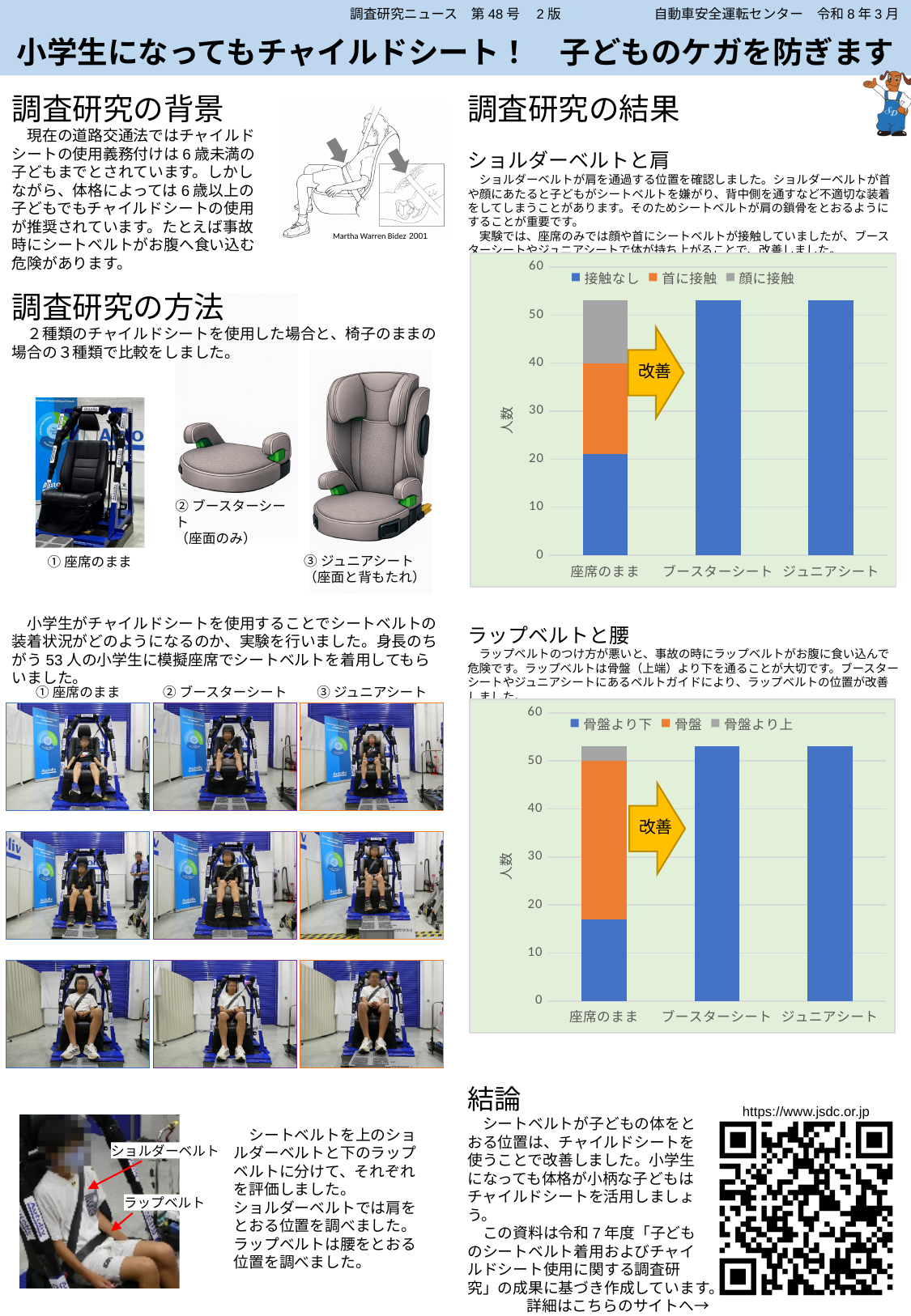
In the upper chart (ショルダーベルトと肩), how many categories are shown on the x axis? 3 In the lower chart (ラップベルトと腰), is the total bar height for ジュニアシート greater or less than 50? greater In the lower chart (ラップベルトと腰), is the 骨盤より下 value for 座席のまま greater or less than 20? less In the upper chart (ショルダーベルトと肩), which category has the smallest 接触なし segment? 座席のまま In the lower chart (ラップベルトと腰), how many series does the legend list? 3 In the upper chart (ショルダーベルトと肩), is the total bar height for ブースターシート greater or less than 50? greater In the lower chart (ラップベルトと腰), what is the label on the y axis? 人数 In the upper chart (ショルダーベルトと肩), how many series does the legend list? 3 In the lower chart (ラップベルトと腰), which has the larger 骨盤より下 value, 座席のまま or ジュニアシート? ジュニアシート In the upper chart (ショルダーベルトと肩), what are the legend entries? 接触なし, 首に接触, 顔に接触 In the upper chart (ショルダーベルトと肩), what kind of chart is shown? Stacked bar chart